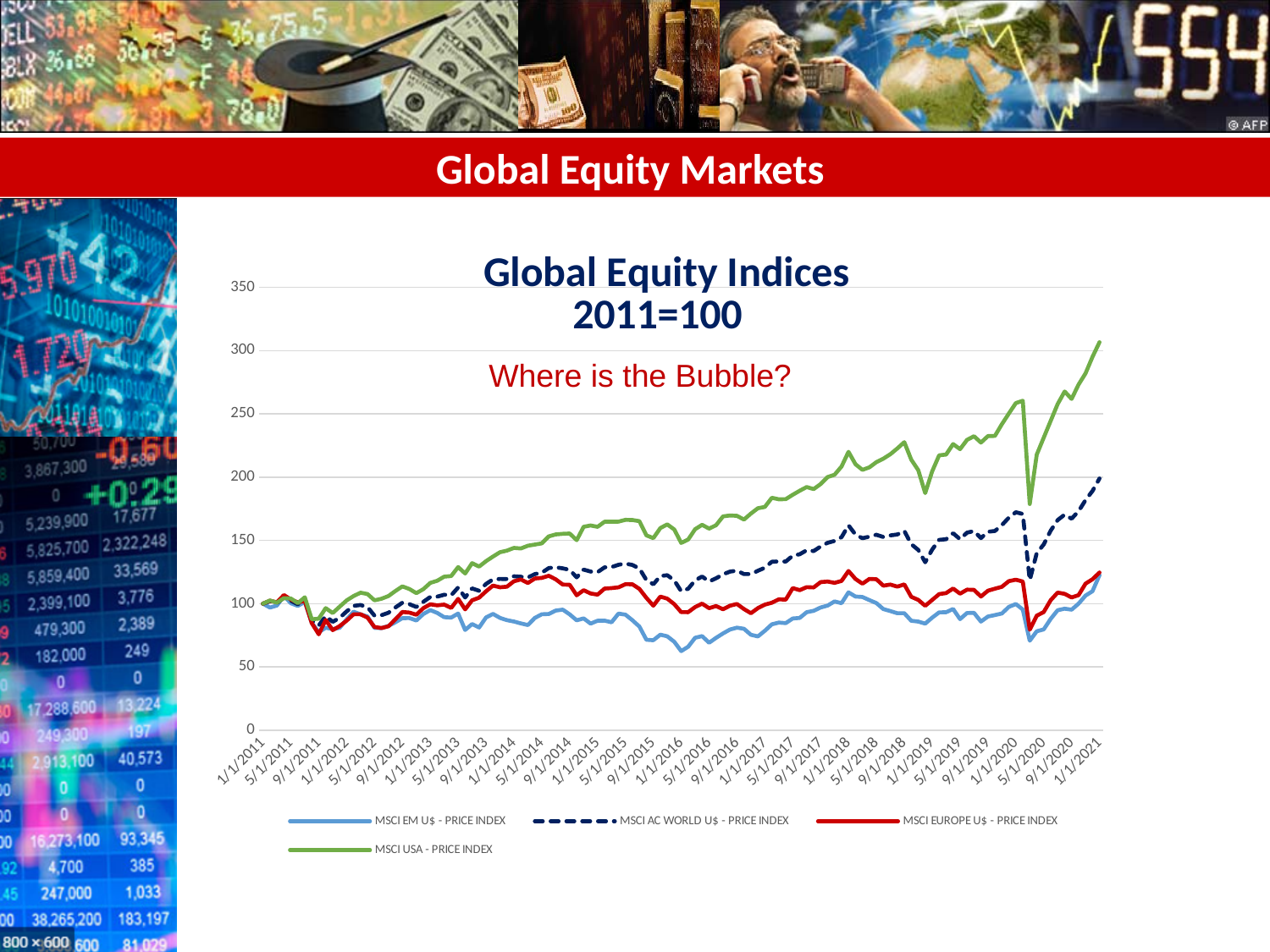
Is the value of MSCI USA - PRICE INDEX at 1/1/2018 greater or less than 200? greater Which series reaches the lowest value anywhere on the Global Equity Indices chart? MSCI EM U$ - PRICE INDEX Is the value of MSCI USA - PRICE INDEX at 1/1/2021 greater or less than 250? greater What is the title of the chart on the slide? Global Equity Indices 2011=100 Is the value of MSCI AC WORLD U$ - PRICE INDEX at 1/1/2021 greater or less than 150? greater What question is written in red inside the chart area? Where is the Bubble? How many series does the legend of the Global Equity Indices chart list? 4 Which series is the highest at 1/1/2021 in the Global Equity Indices chart? MSCI USA - PRICE INDEX Does the MSCI USA - PRICE INDEX series rise or fall overall from 1/1/2011 to 1/1/2021? rise At 1/1/2021, which is larger: MSCI USA - PRICE INDEX or MSCI EM U$ - PRICE INDEX? MSCI USA - PRICE INDEX What kind of chart is shown on the slide? line chart